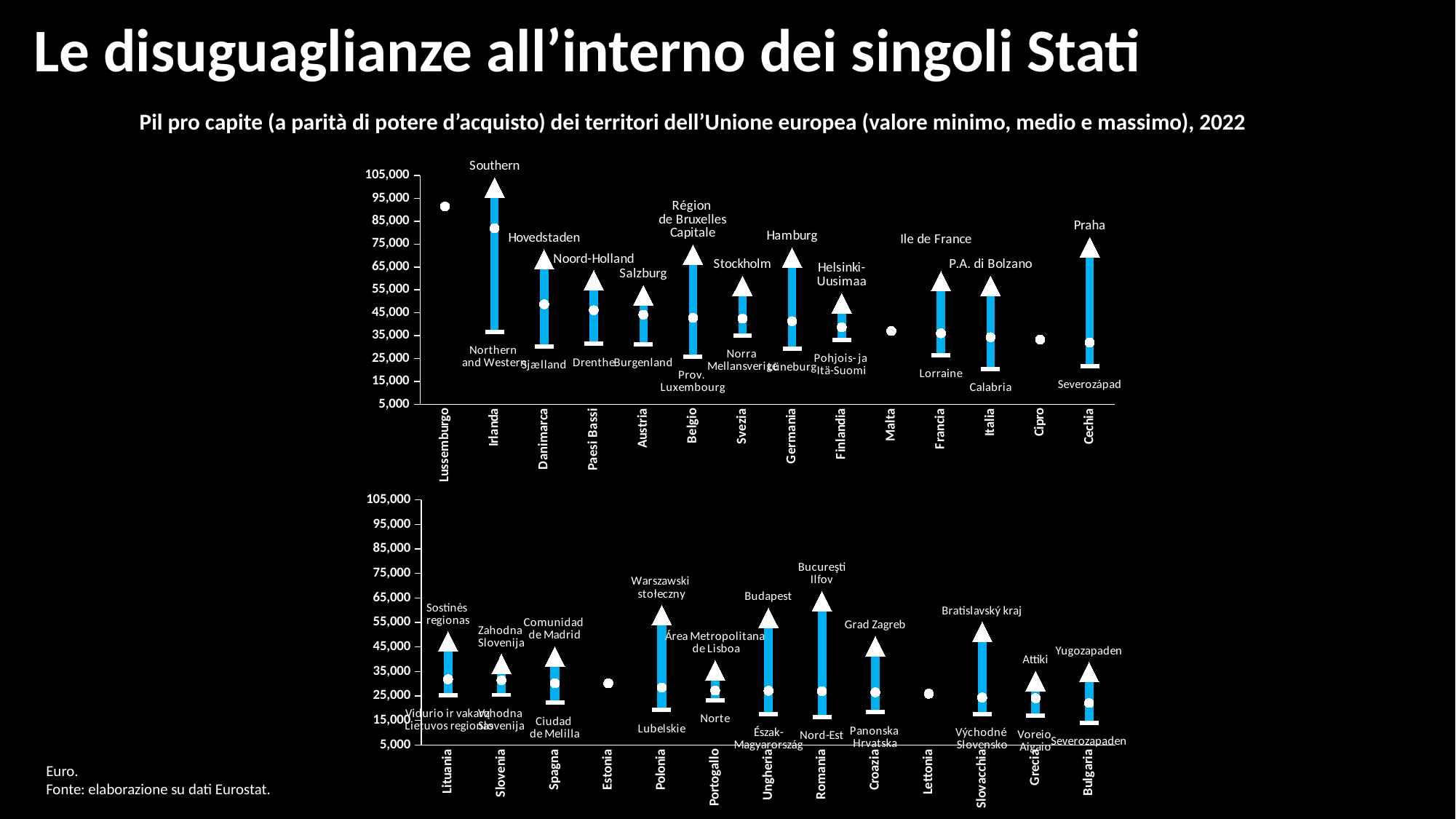
In the top chart, is the maximum value for Cechia (Praha) greater or less than 65,000? greater In the top chart, is the maximum value for Irlanda greater or less than 95,000? greater In the top chart, is the value for Lussemburgo greater or less than 85,000? greater In the top chart, which region is labelled as the minimum for Italia? Calabria In the top chart, how many countries are shown on the x axis? 14 In the bottom chart, which country has the highest maximum regional value? Romania In the top chart, which country has the highest maximum regional value? Irlanda In the bottom chart, how many countries are shown on the x axis? 13 In the top chart, which region is labelled as the maximum for Irlanda? Southern